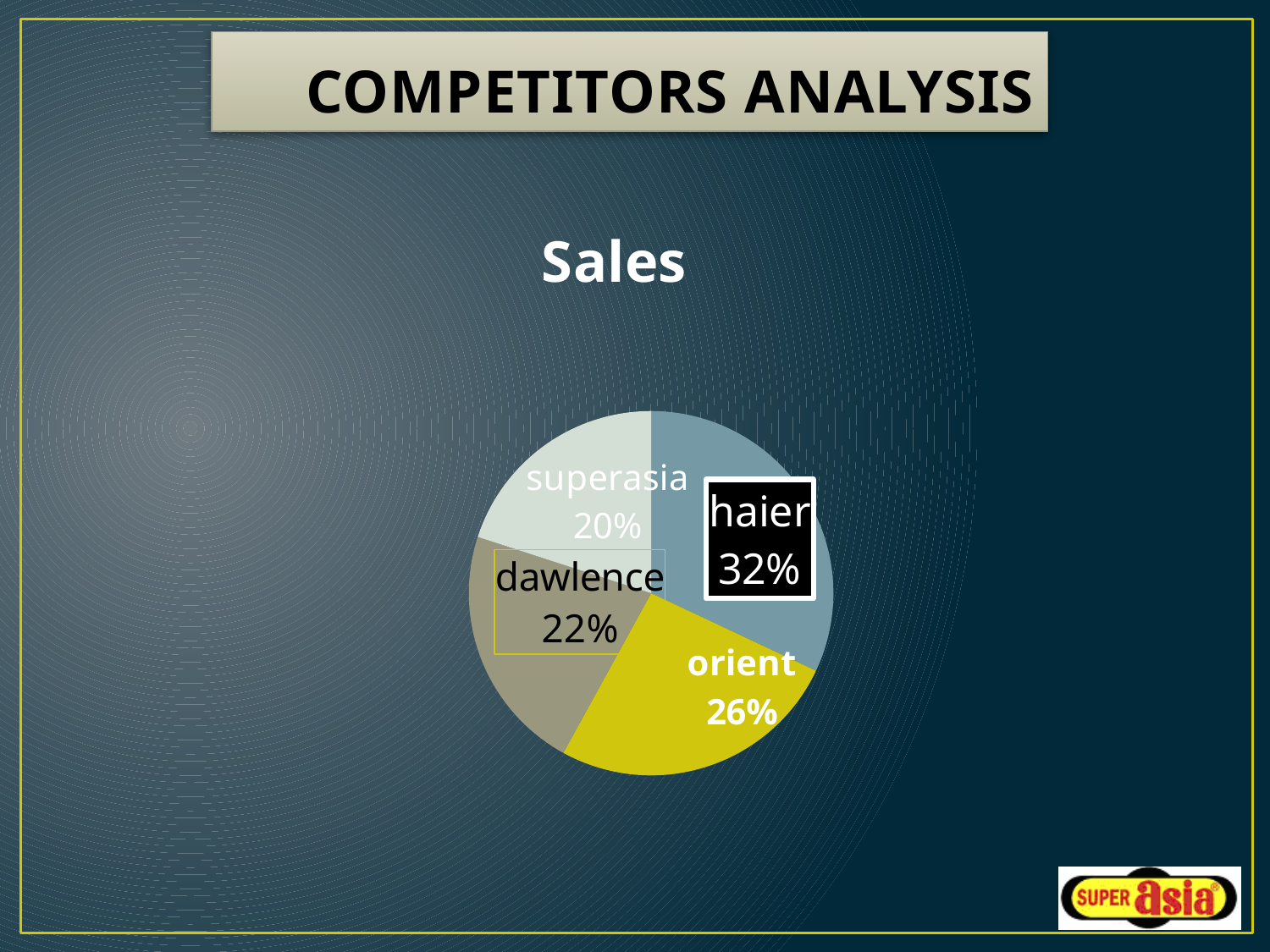
What share of sales does orient have? 26% What type of chart is shown on the slide? pie chart What colour is the orient slice? yellow What share of sales does haier have? 32% What share of sales does dawlence have? 22% Which has a larger share of sales, orient or dawlence? orient Which competitor has the largest share of sales? haier What is the title of the chart? Sales What is the difference in percentage points between haier's and superasia's shares? 12 What share of sales does superasia have? 20% How many slices does the pie chart have? 4 Which competitor has the smallest share of sales? superasia